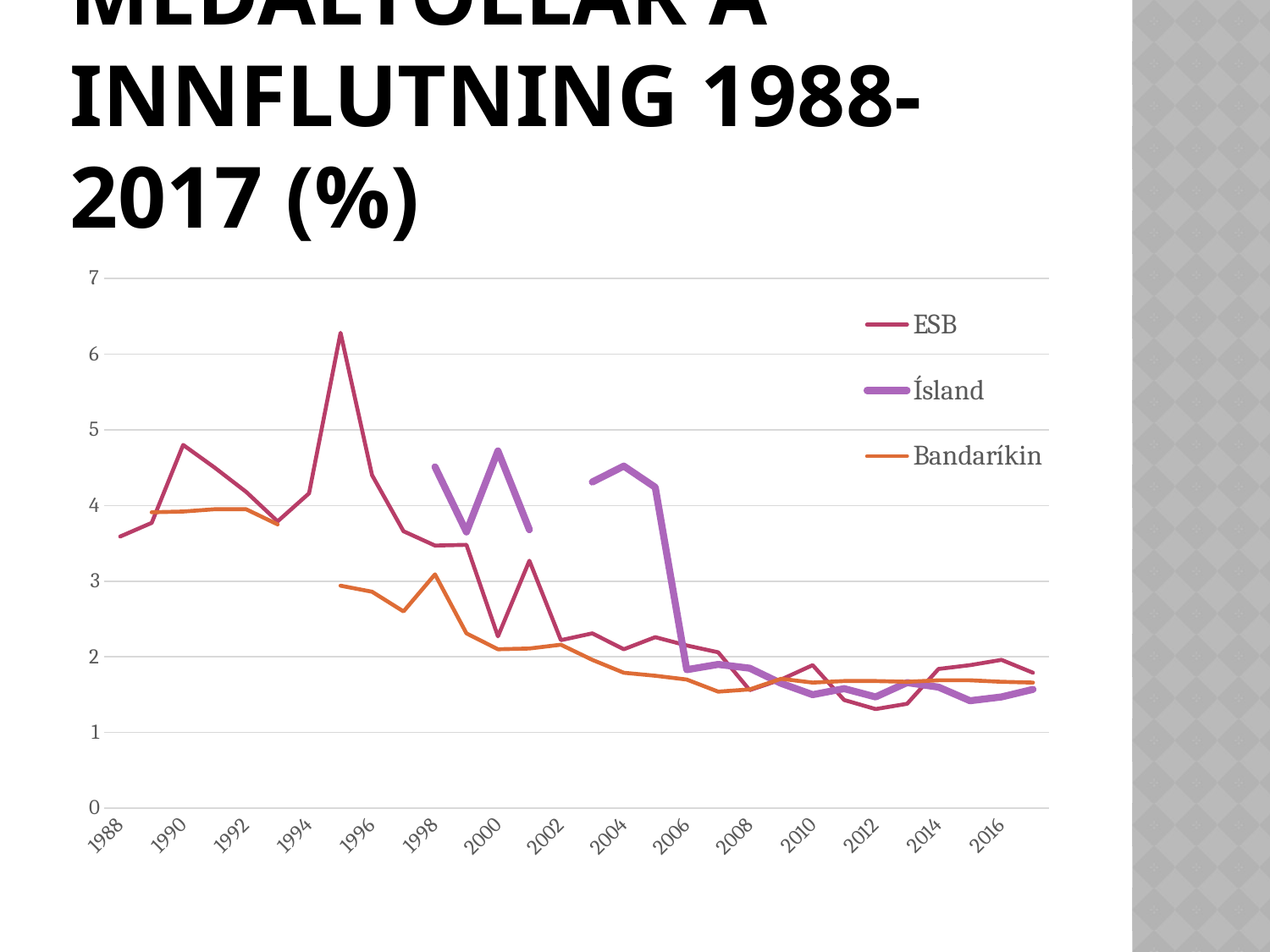
How many series does the legend list? 3 Is the value for Bandaríkin in 2016 greater or less than 2? less Is the value for ESB in 1988 greater or less than 3? greater Which series is drawn with the thickest line? Ísland Which three series are listed in the legend? ESB, Ísland, Bandaríkin Is the value for Ísland in 2004 greater or less than 4? greater In 1996, which series has the larger value, ESB or Bandaríkin? ESB What kind of chart is shown on the slide? line chart In 2004, which series has the larger value, ESB or Ísland? Ísland Overall, does the ESB series rise or fall from 1988 to 2017? fall Which series reaches the highest value anywhere on the chart? ESB